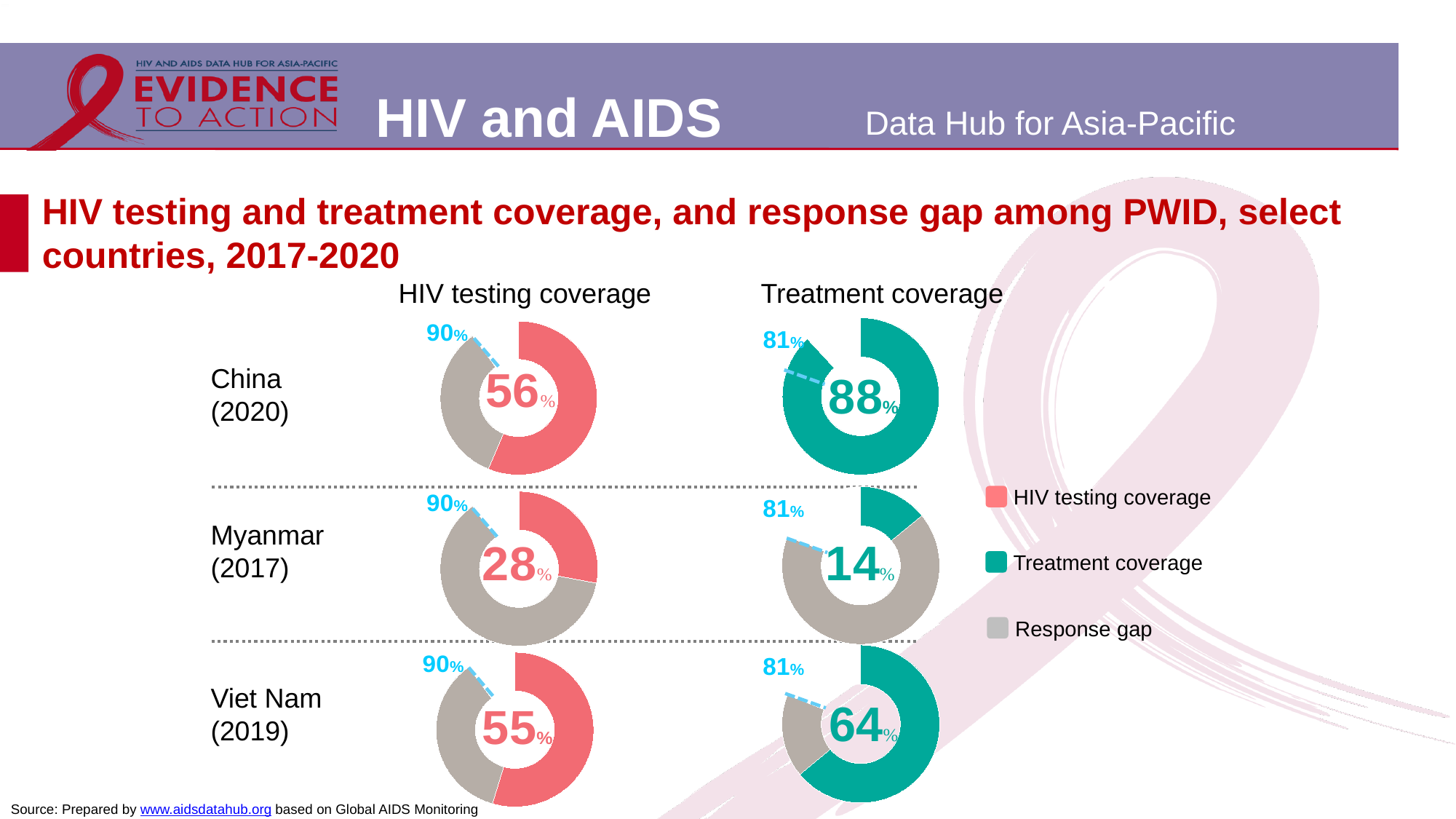
What is the HIV testing coverage for China (2020)? 56% What is the HIV testing coverage for Viet Nam (2019)? 55% How many countries are shown on the slide? 3 What kind of chart is used to show the coverage values? Donut (pie) chart Which country has the highest treatment coverage? China (2020) What is the difference between the treatment coverage of China (2020) and Viet Nam (2019)? 24% What target value is marked on each treatment coverage donut? 81% What is the treatment coverage for China (2020)? 88% Which country has the lowest HIV testing coverage? Myanmar (2017) What is the treatment coverage for Myanmar (2017)? 14% What target value is marked on each HIV testing coverage donut? 90% Which is larger for Myanmar (2017): HIV testing coverage or treatment coverage? HIV testing coverage